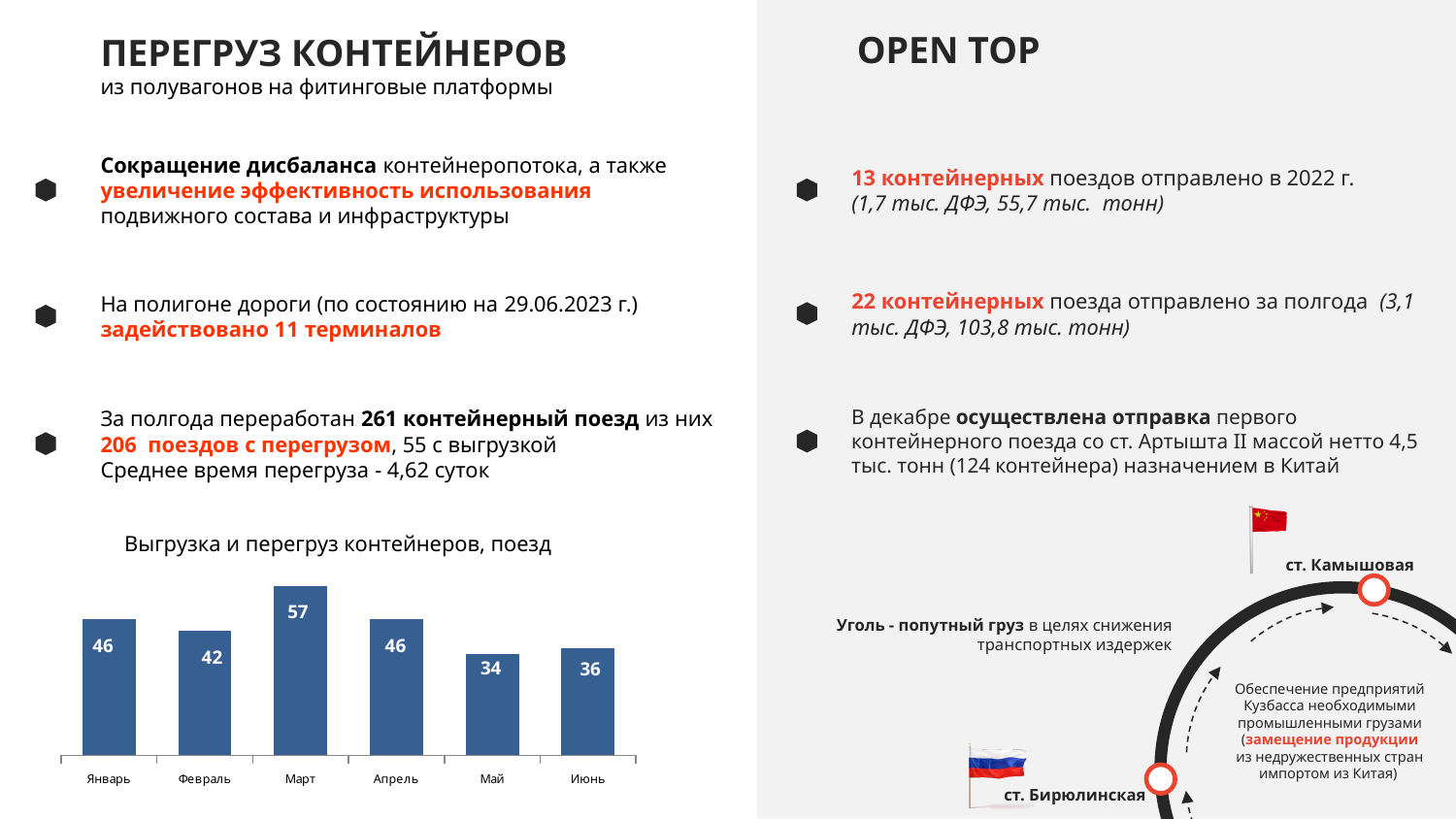
In the chart 'Выгрузка и перегруз контейнеров, поезд', which is larger: the value for Апрель or the value for Июнь? Апрель What is the title of the bar chart on the slide? Выгрузка и перегруз контейнеров, поезд What is the value for Май in the chart 'Выгрузка и перегруз контейнеров, поезд'? 34 What is the difference between the values for Март and Май in the chart 'Выгрузка и перегруз контейнеров, поезд'? 23 In the chart 'Выгрузка и перегруз контейнеров, поезд', do the values rise or fall from Апрель to Май? Fall What is the value for Март in the chart 'Выгрузка и перегруз контейнеров, поезд'? 57 Which month has the lowest value in the chart 'Выгрузка и перегруз контейнеров, поезд'? Май What kind of chart is 'Выгрузка и перегруз контейнеров, поезд'? Bar chart What is the difference between the values for Январь and Февраль in the chart 'Выгрузка и перегруз контейнеров, поезд'? 4 What is the value for Февраль in the chart 'Выгрузка и перегруз контейнеров, поезд'? 42 How many months are shown in the chart 'Выгрузка и перегруз контейнеров, поезд'? 6 Which month has the highest value in the chart 'Выгрузка и перегруз контейнеров, поезд'? Март